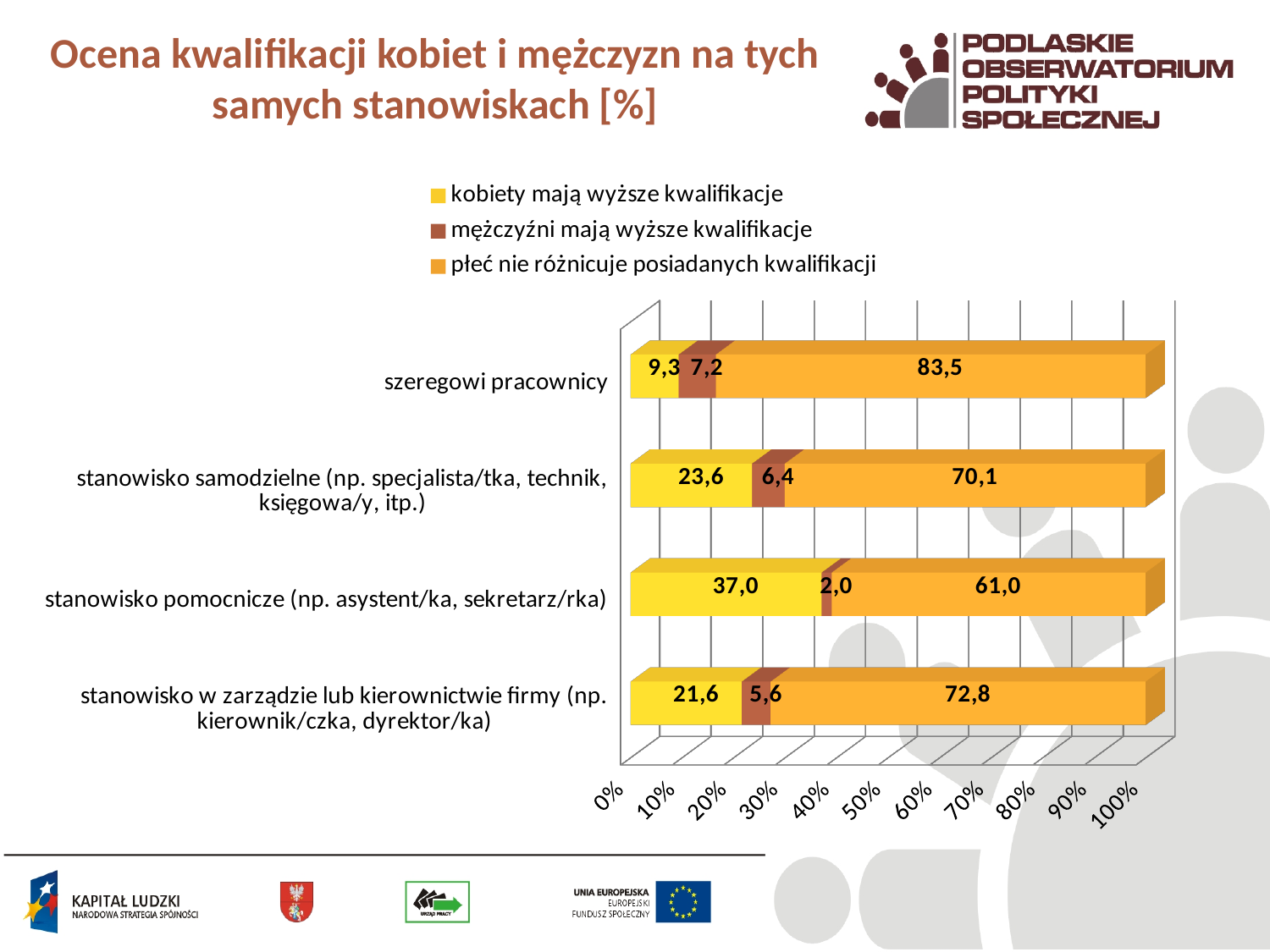
What is the total of the stacked bar for 'stanowisko w zarządzie lub kierownictwie firmy (np. kierownik/czka, dyrektor/ka)'? 100,0 What is the value of 'płeć nie różnicuje posiadanych kwalifikacji' for 'stanowisko samodzielne (np. specjalista/tka, technik, księgowa/y, itp.)'? 70,1 What is the value of 'mężczyźni mają wyższe kwalifikacje' for 'stanowisko pomocnicze (np. asystent/ka, sekretarz/rka)'? 2,0 How many series does the legend list? 3 What is the value of 'kobiety mają wyższe kwalifikacje' for 'stanowisko w zarządzie lub kierownictwie firmy (np. kierownik/czka, dyrektor/ka)'? 21,6 Which category has the highest value for 'kobiety mają wyższe kwalifikacje'? stanowisko pomocnicze (np. asystent/ka, sekretarz/rka) What is the difference between the 'płeć nie różnicuje posiadanych kwalifikacji' values for 'szeregowi pracownicy' and 'stanowisko pomocnicze (np. asystent/ka, sekretarz/rka)'? 22,5 What type of chart is shown on the slide? stacked bar chart What is the value of 'kobiety mają wyższe kwalifikacje' for 'szeregowi pracownicy'? 9,3 Which category has the lowest value for 'mężczyźni mają wyższe kwalifikacje'? stanowisko pomocnicze (np. asystent/ka, sekretarz/rka) Which is larger: the 'mężczyźni mają wyższe kwalifikacje' value for 'szeregowi pracownicy' or for 'stanowisko samodzielne (np. specjalista/tka, technik, księgowa/y, itp.)'? szeregowi pracownicy How many categories (job positions) are shown on the chart? 4